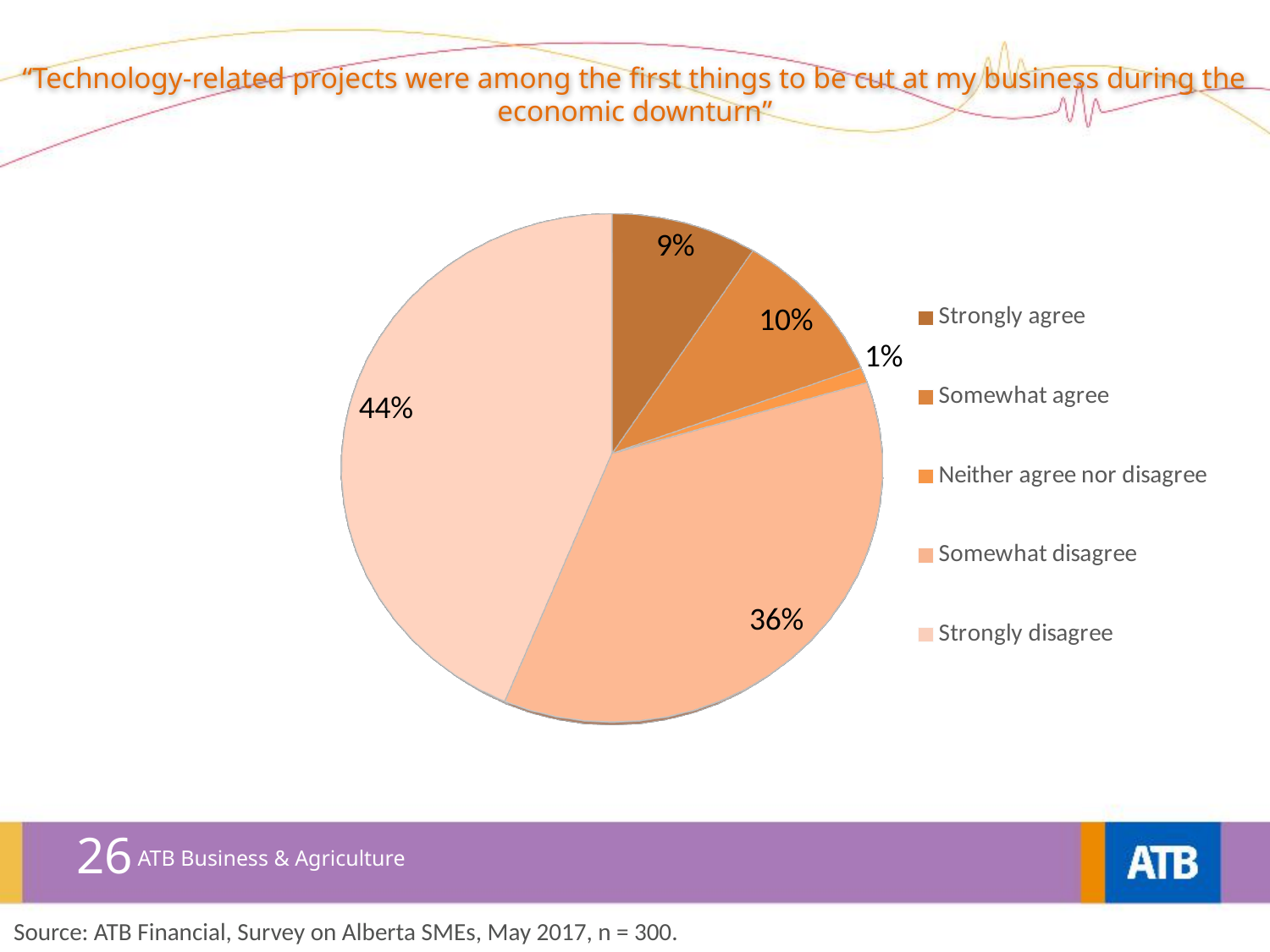
What is the difference in percentage points between Strongly disagree and Somewhat disagree? 8 How many categories does the legend list? 5 What kind of chart is shown on the slide? pie chart What percentage of respondents somewhat disagree? 36% What percentage of respondents strongly disagree? 44% Which response category has the largest share of the pie? Strongly disagree What is the combined share of respondents who strongly or somewhat disagree? 80% Which response category has the smallest share of the pie? Neither agree nor disagree What percentage of respondents somewhat agree? 10% What percentage of respondents strongly agree? 9% What percentage of respondents neither agree nor disagree? 1% Which is larger, the share for Somewhat agree or the share for Strongly agree? Somewhat agree